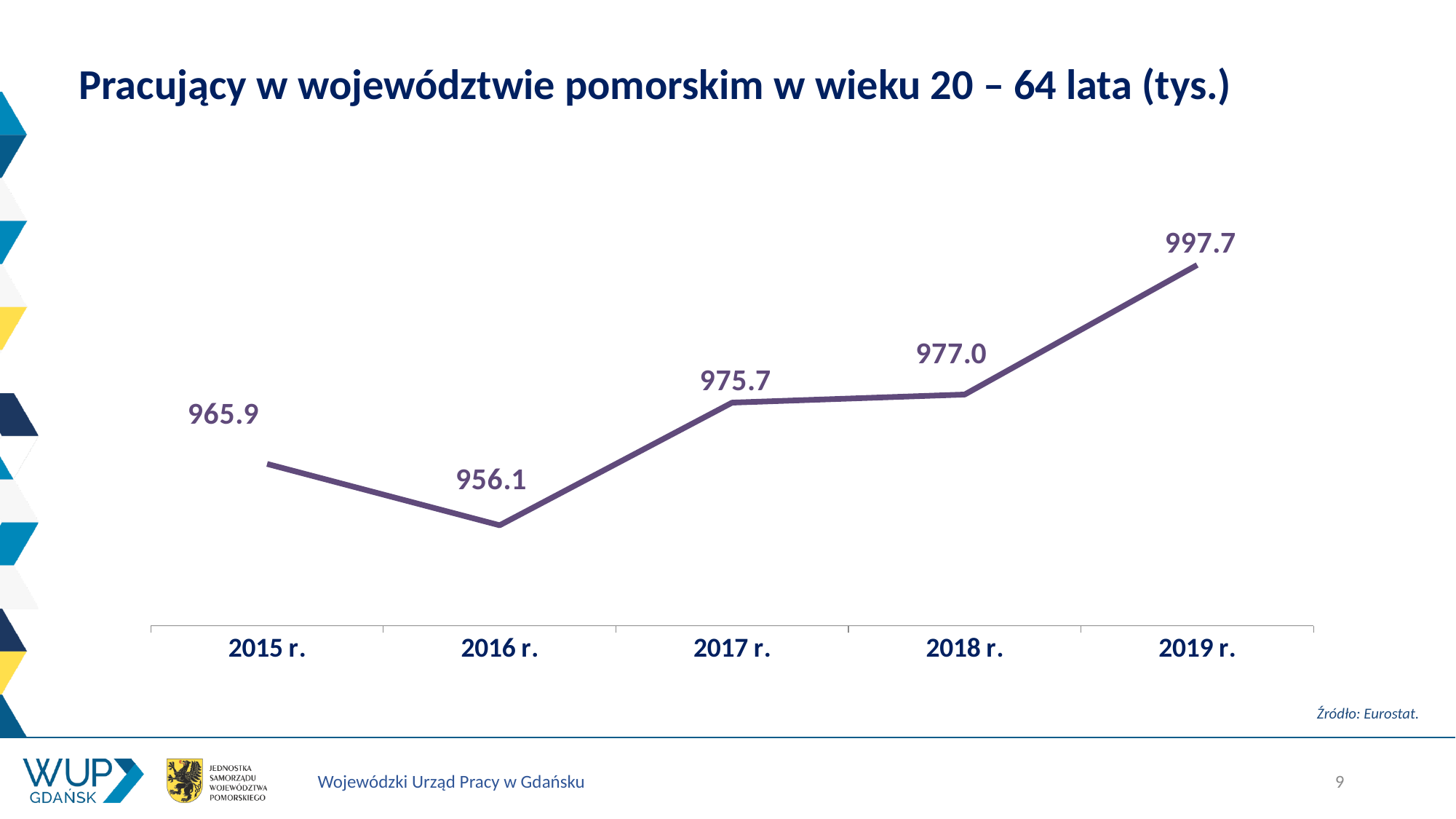
Which year has the lowest value? 2016 r. What is the value for 2015 r.? 965.9 What is the title of the chart? Pracujący w województwie pomorskim w wieku 20 – 64 lata (tys.) What is the difference between the values for 2015 r. and 2016 r.? 9.8 Which is larger, the value for 2017 r. or the value for 2015 r.? 2017 r. How many years are plotted on the chart? 5 What is the difference between the values for 2019 r. and 2018 r.? 20.7 What is the value for 2019 r.? 997.7 Which year has the highest value? 2019 r. What kind of chart is shown on the slide? line chart What is the value for 2017 r.? 975.7 What is the value for 2016 r.? 956.1